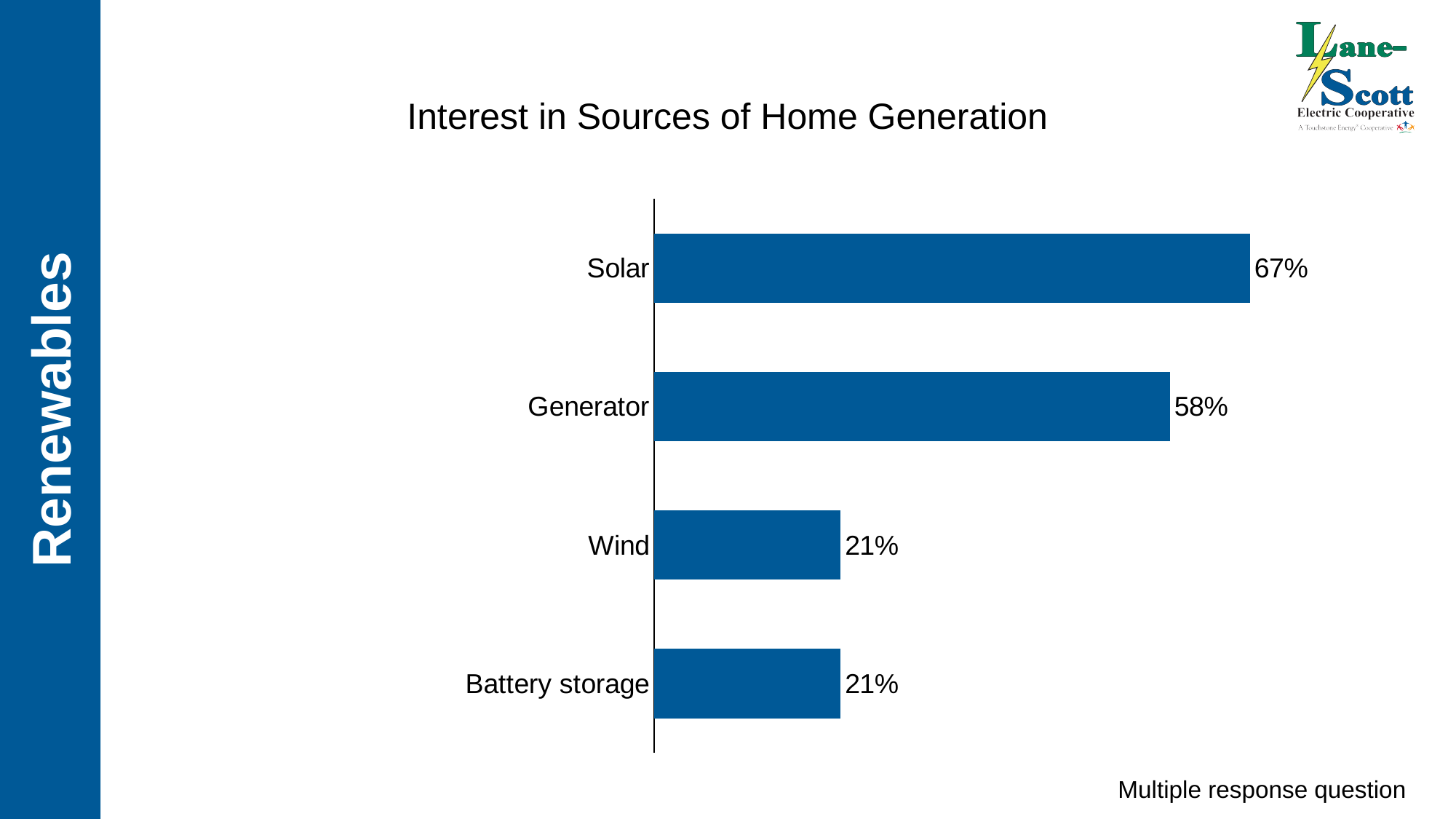
What is the difference between the values for Solar and Generator? 9% Which is larger, the value for Generator or the value for Wind? Generator Which category has the highest value? Solar What is the value for Battery storage? 21% What is the value for Wind? 21% How many categories are shown in the chart? 4 What note appears at the bottom right of the slide below the chart? Multiple response question What kind of chart is shown on the slide? Bar chart What is the title of the chart? Interest in Sources of Home Generation What is the value for Solar? 67% What is the difference between the values for Generator and Wind? 37% What is the value for Generator? 58%